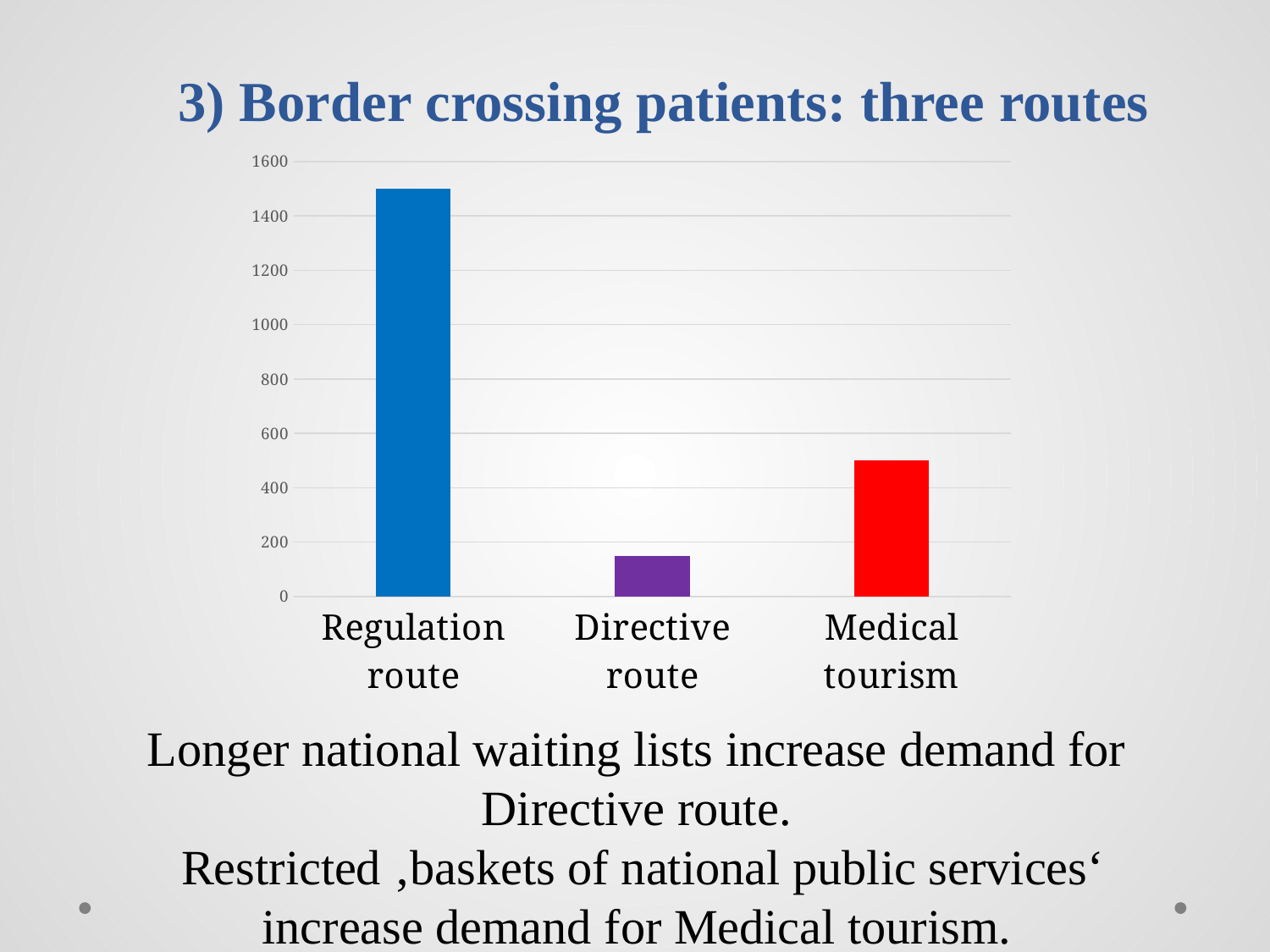
Is the value for Medical tourism greater or less than 400? greater What is the title of the slide containing the chart? 3) Border crossing patients: three routes Which is larger, the value for Medical tourism or the value for Directive route? Medical tourism Which category has the lowest value in the chart? Directive route Is the value for Regulation route greater or less than 1400? greater Is the value for Medical tourism greater or less than 600? less Do the values rise or fall from Regulation route to Directive route? fall How many categories are shown on the x axis of the chart? 3 Which category has the highest value in the chart? Regulation route What kind of chart is shown on the slide? bar chart Which is larger, the value for Regulation route or the value for Medical tourism? Regulation route